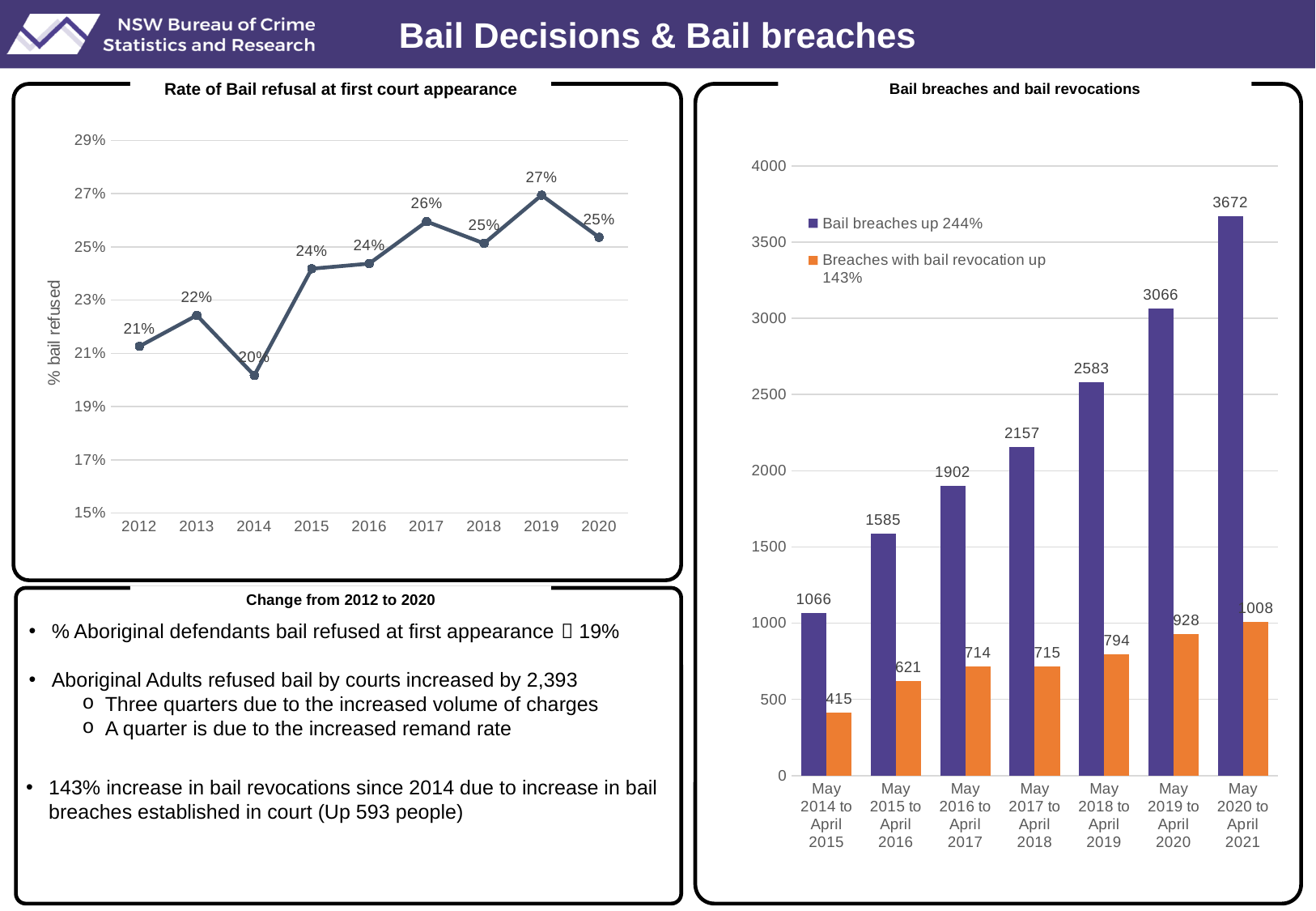
In the 'Rate of Bail refusal at first court appearance' chart, how many years are plotted? 9 In the 'Rate of Bail refusal at first court appearance' chart, which year has the highest rate? 2019 In the 'Rate of Bail refusal at first court appearance' chart, which year has the lowest rate? 2014 In the 'Bail breaches and bail revocations' chart, what is the value of Bail breaches for May 2020 to April 2021? 3672 What kind of chart is 'Bail breaches and bail revocations'? Bar chart What kind of chart is 'Rate of Bail refusal at first court appearance'? Line chart In the 'Bail breaches and bail revocations' chart, what is the difference between Bail breaches and Breaches with bail revocation for May 2018 to April 2019? 1789 In the 'Bail breaches and bail revocations' chart, how many series does the legend list? 2 In the 'Rate of Bail refusal at first court appearance' chart, what is the value for 2014? 20% In the 'Bail breaches and bail revocations' chart, what is the value of Breaches with bail revocation for May 2014 to April 2015? 415 In the 'Bail breaches and bail revocations' chart, which colour represents Breaches with bail revocation? Orange In the 'Bail breaches and bail revocations' chart, do the Bail breaches values rise or fall from left to right? Rise